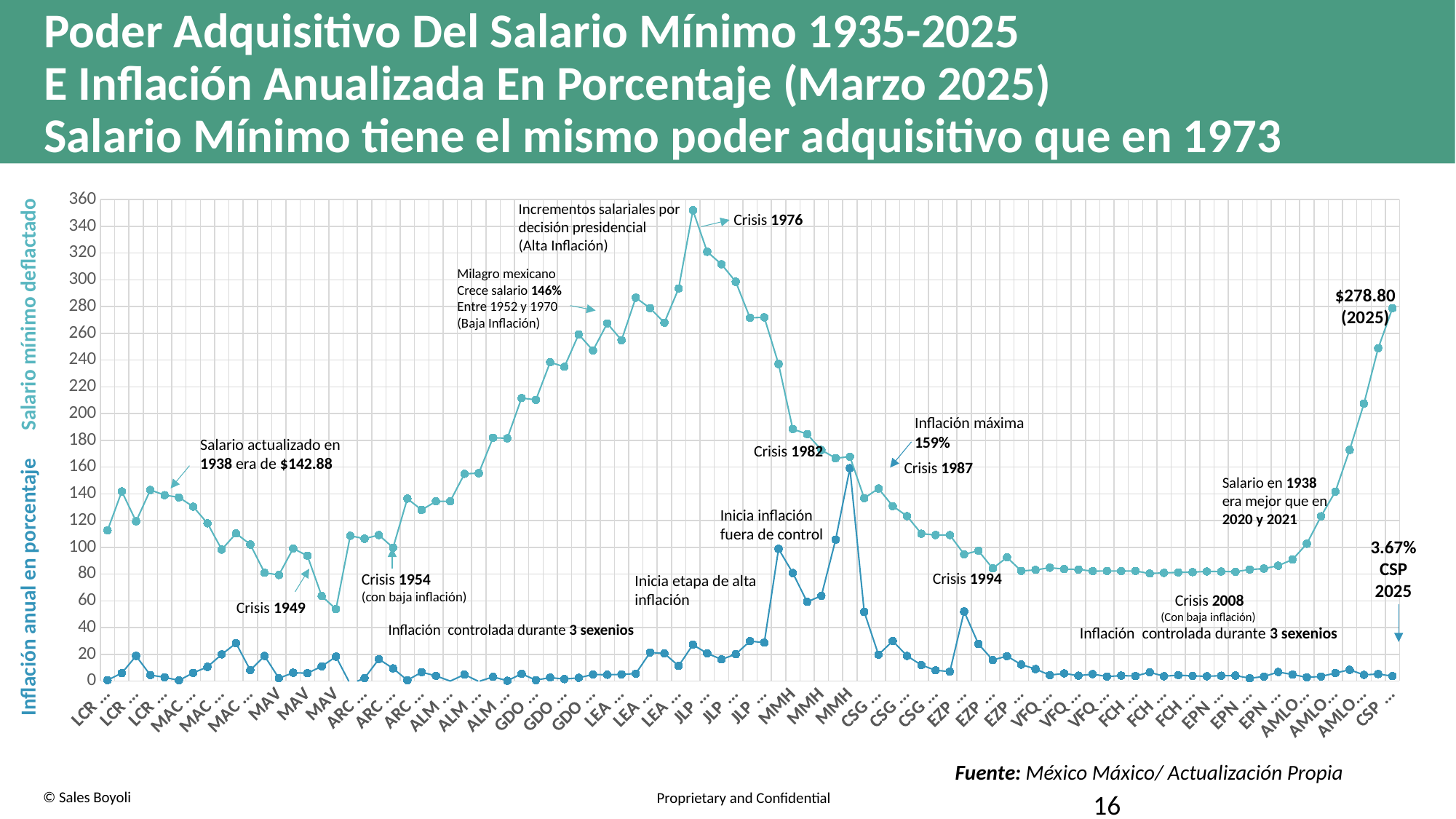
What source is cited below the chart? México Máxico/ Actualización Propia What annual inflation percentage is labelled for CSP 2025? 3.67% According to the annotation, what was the updated minimum wage in 1938? $142.88 Is the peak of the deflated minimum wage line around Crisis 1976 greater or less than 340? greater What kind of chart is shown on the slide? line chart By how much does the 2025 deflated minimum wage ($278.80) exceed the 1938 value ($142.88)? $135.92 Is the deflated minimum wage during the VFQ and FCH periods greater or less than 100? less What is the maximum annual inflation value labelled on the chart? 159% What is the deflated minimum wage value labelled for 2025? $278.80 In which crisis year does the deflated minimum wage line reach its highest point? 1976 Which is larger, the deflated minimum wage in 2025 or in 1938? 2025 Does the deflated minimum wage line rise or fall from the AMLO period to CSP? rise